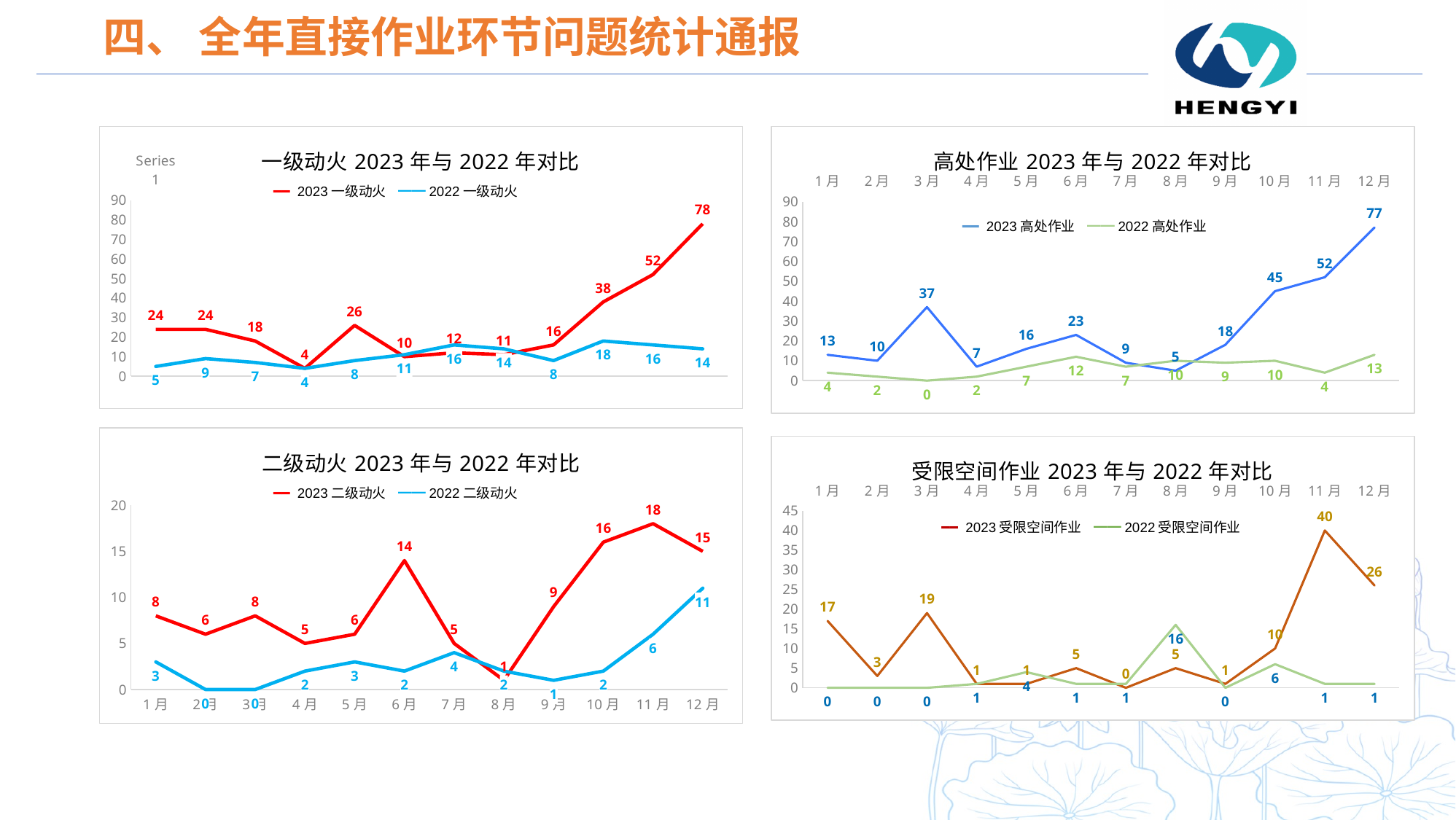
In the 二级动火 2023 年与 2022 年对比 chart, which month has the highest value for 2023 二级动火? 11月 In the 二级动火 2023 年与 2022 年对比 chart, which is larger in 12月: 2023 二级动火 or 2022 二级动火? 2023 二级动火 What kind of chart is the 受限空间作业 2023 年与 2022 年对比 chart? Line chart In the 受限空间作业 2023 年与 2022 年对比 chart, which month has the highest value for 2022 受限空间作业? 8月 In the 二级动火 2023 年与 2022 年对比 chart, what is the value for 2023 二级动火 in 6月? 14 In the 受限空间作业 2023 年与 2022 年对比 chart, what is the value for 2023 受限空间作业 in 11月? 40 In the 高处作业 2023 年与 2022 年对比 chart, what is the value for 2022 高处作业 in 6月? 12 In the 高处作业 2023 年与 2022 年对比 chart, what is the difference between 2023 高处作业 and 2022 高处作业 in 11月? 48 How many series does the legend of the 一级动火 2023 年与 2022 年对比 chart list? 2 In the 高处作业 2023 年与 2022 年对比 chart, which month has the lowest value for 2022 高处作业? 3月 In the 一级动火 2023 年与 2022 年对比 chart, what is the highest value plotted for 2023 一级动火? 78 In the 高处作业 2023 年与 2022 年对比 chart, what is the value for 2023 高处作业 in 12月? 77